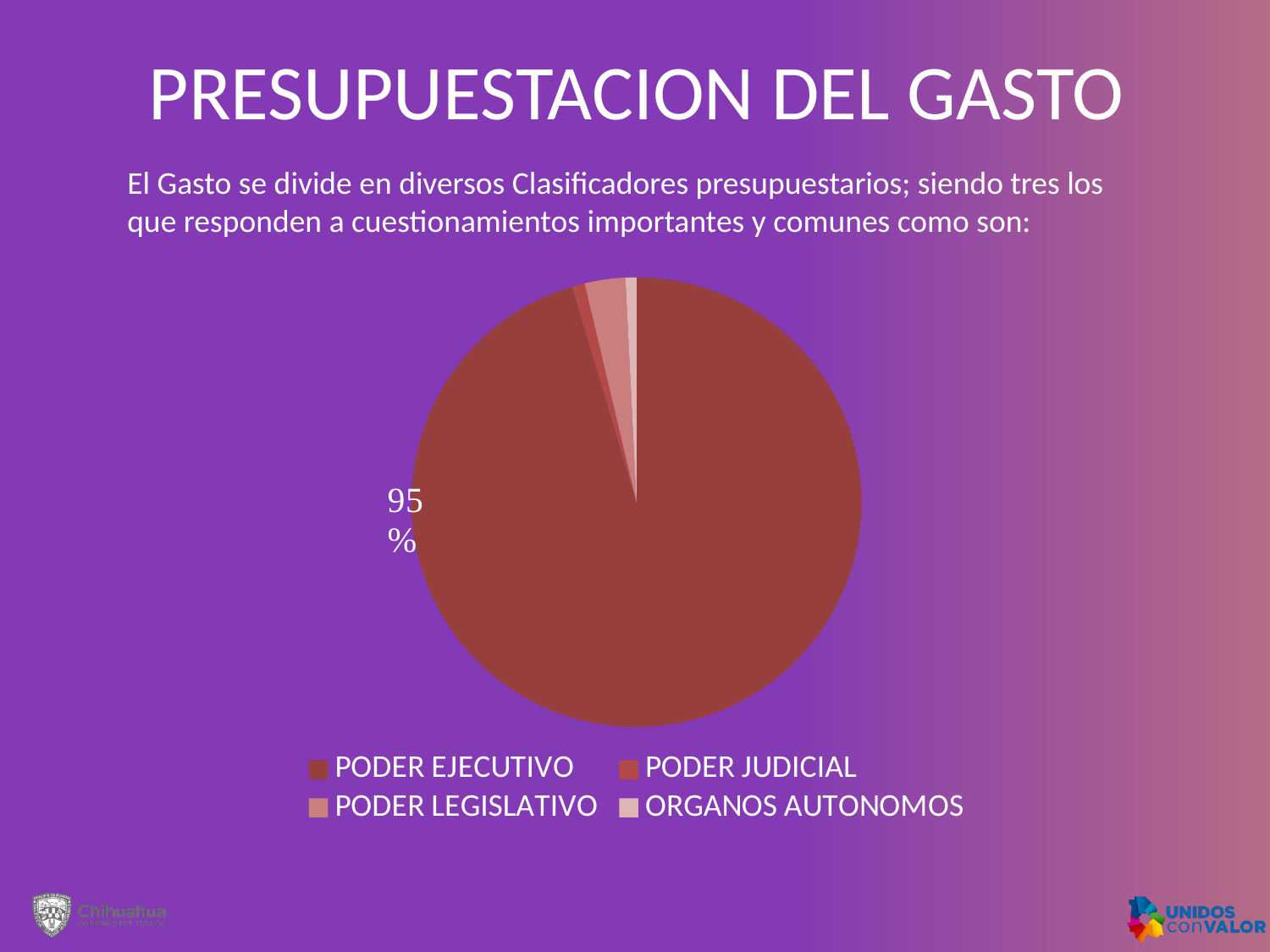
What kind of chart is shown on the slide? Pie chart Which category has the largest slice of the pie chart? PODER EJECUTIVO How many entries does the legend of the pie chart list? 4 What value is printed on the PODER EJECUTIVO slice? 95% What share of the pie does PODER EJECUTIVO represent? 95% Which is larger, the slice for PODER EJECUTIVO or the slice for ORGANOS AUTONOMOS? PODER EJECUTIVO What is the title of the slide containing the pie chart? PRESUPUESTACION DEL GASTO How many categories does the pie chart show? 4 Which is larger, the slice for PODER LEGISLATIVO or the slice for PODER JUDICIAL? PODER LEGISLATIVO Which is larger, the slice for PODER EJECUTIVO or the slice for PODER JUDICIAL? PODER EJECUTIVO